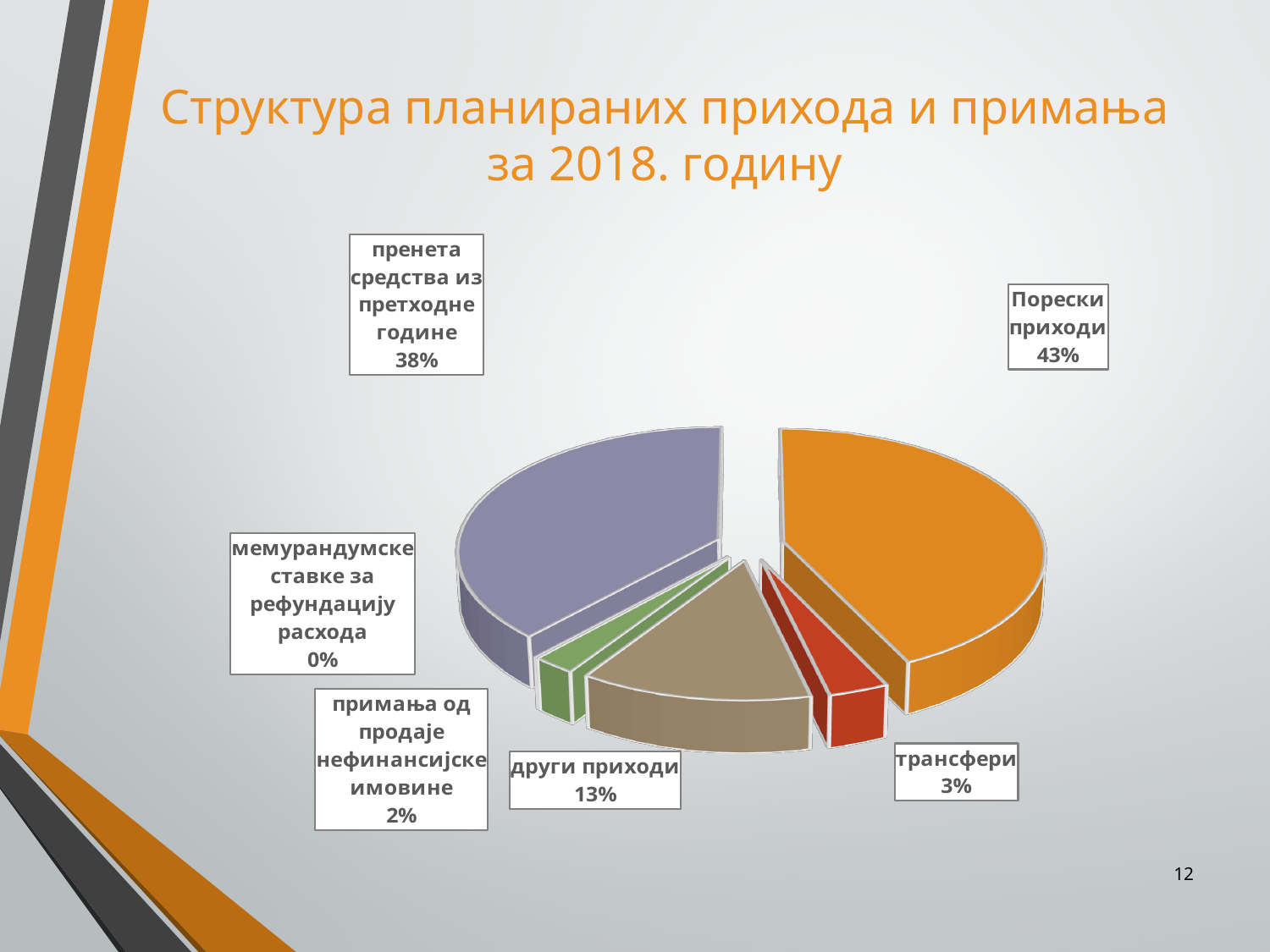
Which category has the largest share of the pie? Порески приходи What share of the pie does "други приходи" have? 13% What is the difference in percentage points between "Порески приходи" and "пренета средства из претходне године"? 5 percentage points What share of the pie does "примања од продаје нефинансијске имовине" have? 2% Which is larger, the share for "други приходи" or the share for "трансфери"? други приходи What share of the pie does "Порески приходи" have? 43% What share of the pie does "мемурандумске ставке за рефундацију расхода" have? 0% How many categories are shown in the pie chart? 6 What kind of chart is shown on the slide? pie chart What share of the pie does "пренета средства из претходне године" have? 38% Which category has the smallest share of the pie? мемурандумске ставке за рефундацију расхода What share of the pie does "трансфери" have? 3%